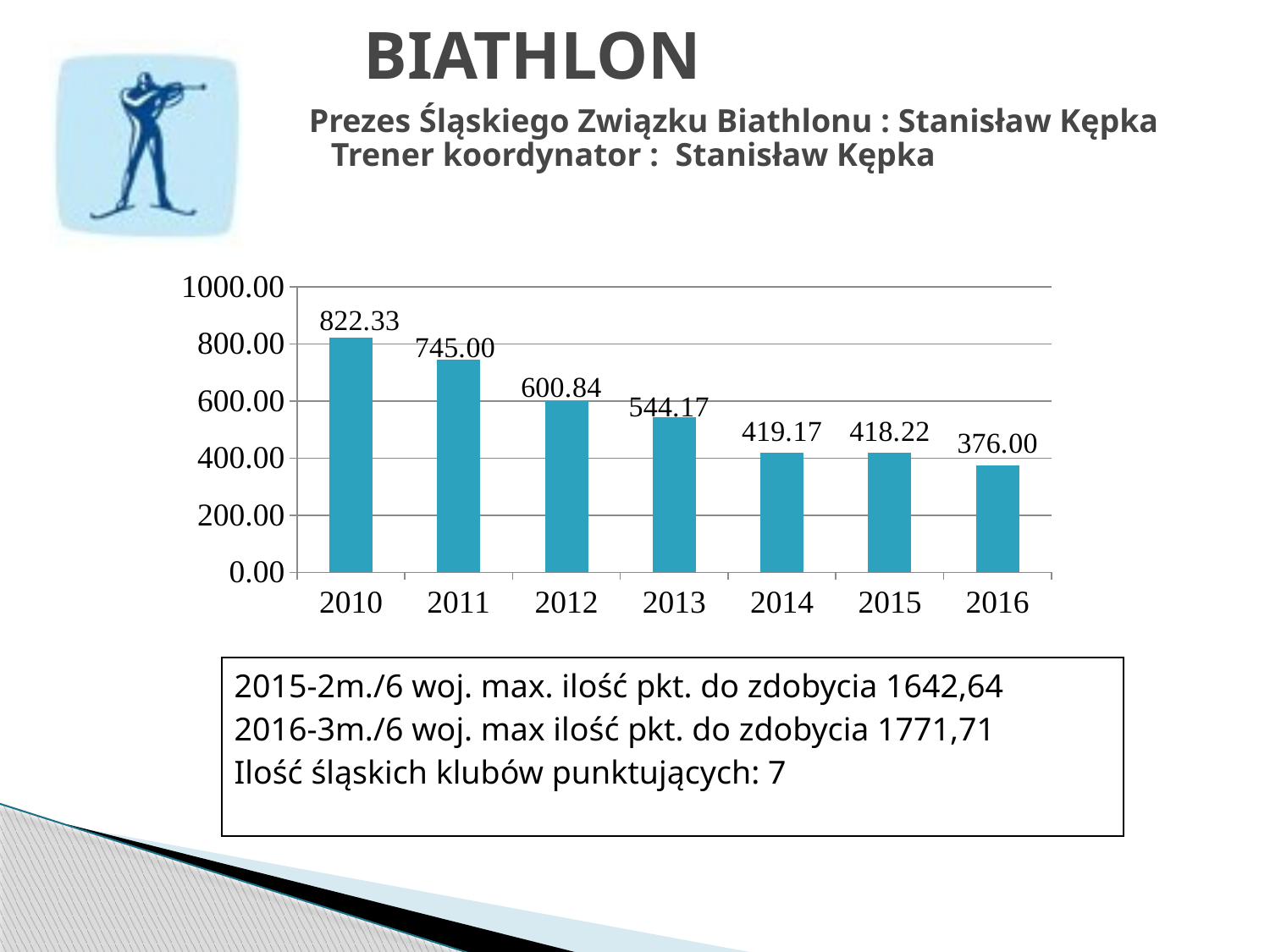
Is the value for 2011 greater or less than 600.00? greater What is the value for 2013? 544.17 What is the difference between the values for 2010 and 2011? 77.33 Which year has the lowest value? 2016 What is the difference between the values for 2012 and 2016? 224.84 Which is larger, the value for 2012 or the value for 2013? 2012 What kind of chart is shown on the slide? bar chart What is the value for 2010? 822.33 What is the value for 2016? 376.00 Which year has the highest value? 2010 Do the values rise or fall from 2010 to 2016? fall How many years are shown on the x axis? 7